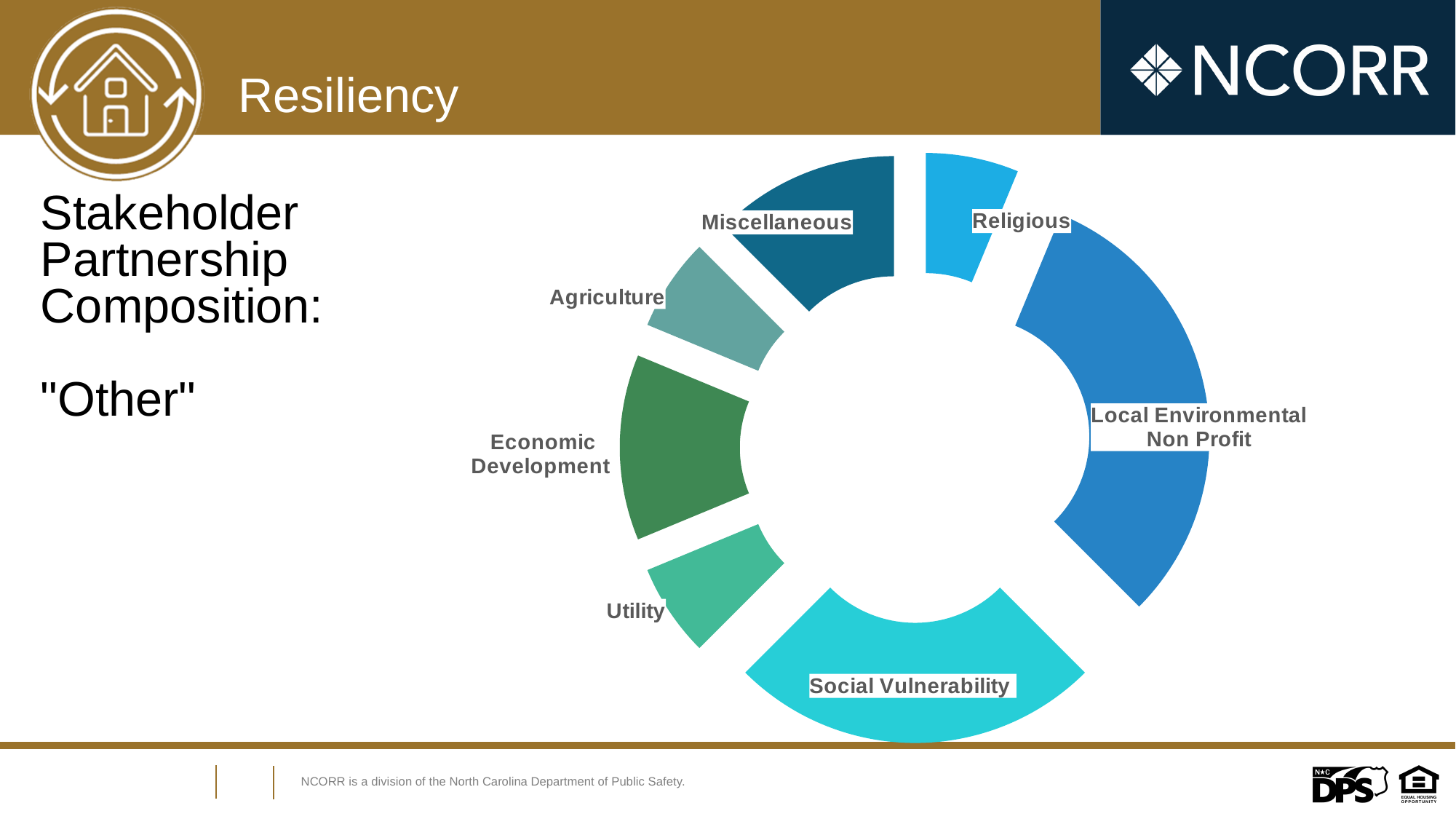
How many categories does the donut chart show? 7 What is the title text to the left of the donut chart? Stakeholder Partnership Composition: "Other" Which category is shown in the dark green segment of the donut chart? Economic Development What kind of chart is shown on the slide? Donut (pie) chart Which is larger in the donut chart, Social Vulnerability or Utility? Social Vulnerability Which is larger in the donut chart, Economic Development or Agriculture? Economic Development Which is larger in the donut chart, Social Vulnerability or Agriculture? Social Vulnerability Which category has the largest share of the donut chart? Local Environmental Non Profit